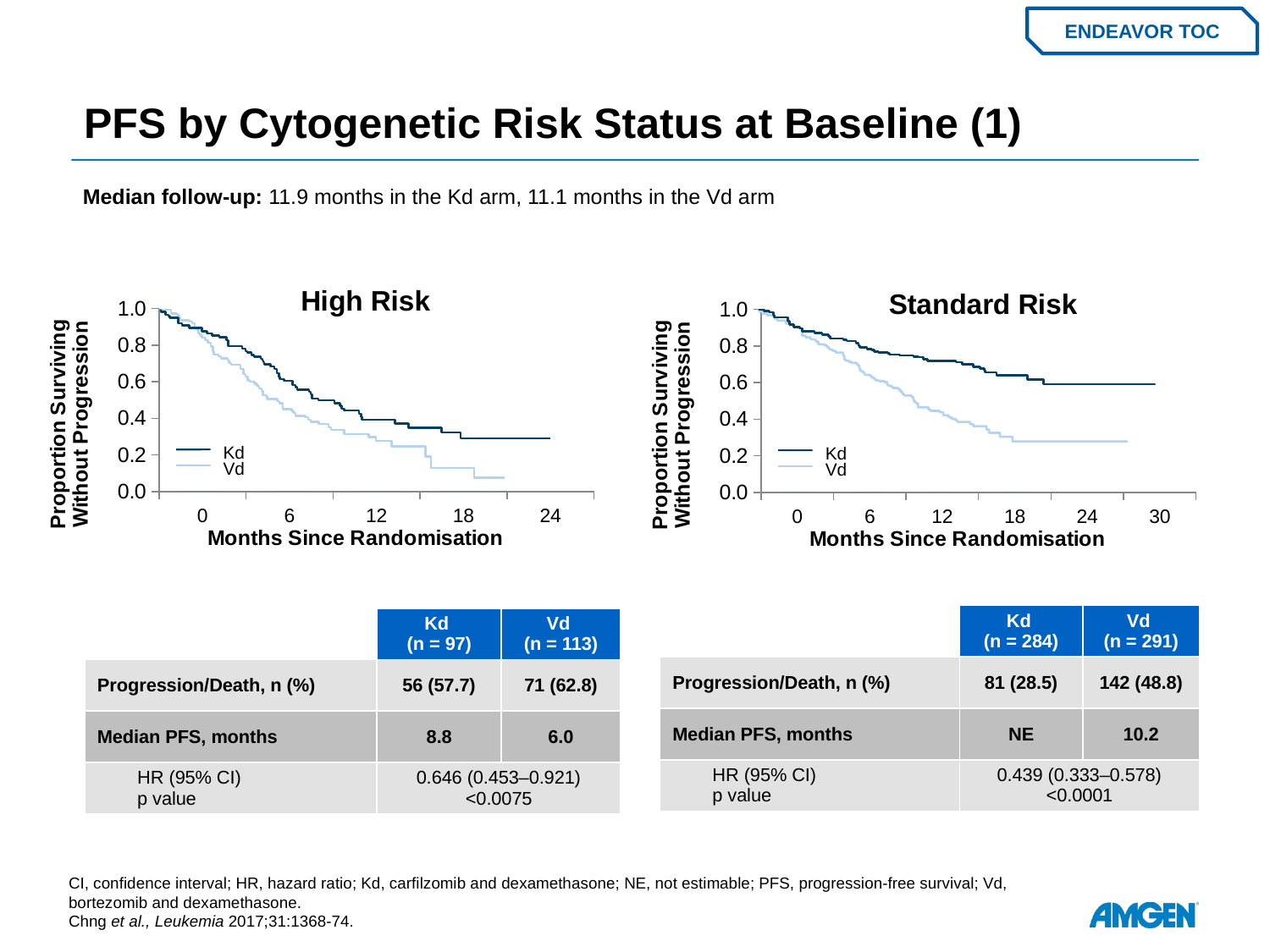
In the High Risk chart, is the Kd proportion surviving without progression at 6 months greater or less than 0.6? greater In the Standard Risk chart, is the Kd proportion surviving without progression at 12 months greater or less than 0.6? greater How many series does the legend of the Standard Risk chart list? 2 In the High Risk chart, which two series are listed in the legend? Kd and Vd In the High Risk chart, is the Kd proportion surviving without progression at 18 months greater or less than 0.2? greater In the Standard Risk chart, which series has the higher proportion surviving without progression at 12 months, Kd or Vd? Kd What kind of chart is the High Risk chart? line chart In the High Risk chart, which series has the lower proportion surviving without progression at 18 months, Kd or Vd? Vd What is the highest tick label on the x axis of the Standard Risk chart? 30 In the Standard Risk chart, do the curves rise or fall as months since randomisation increase? fall